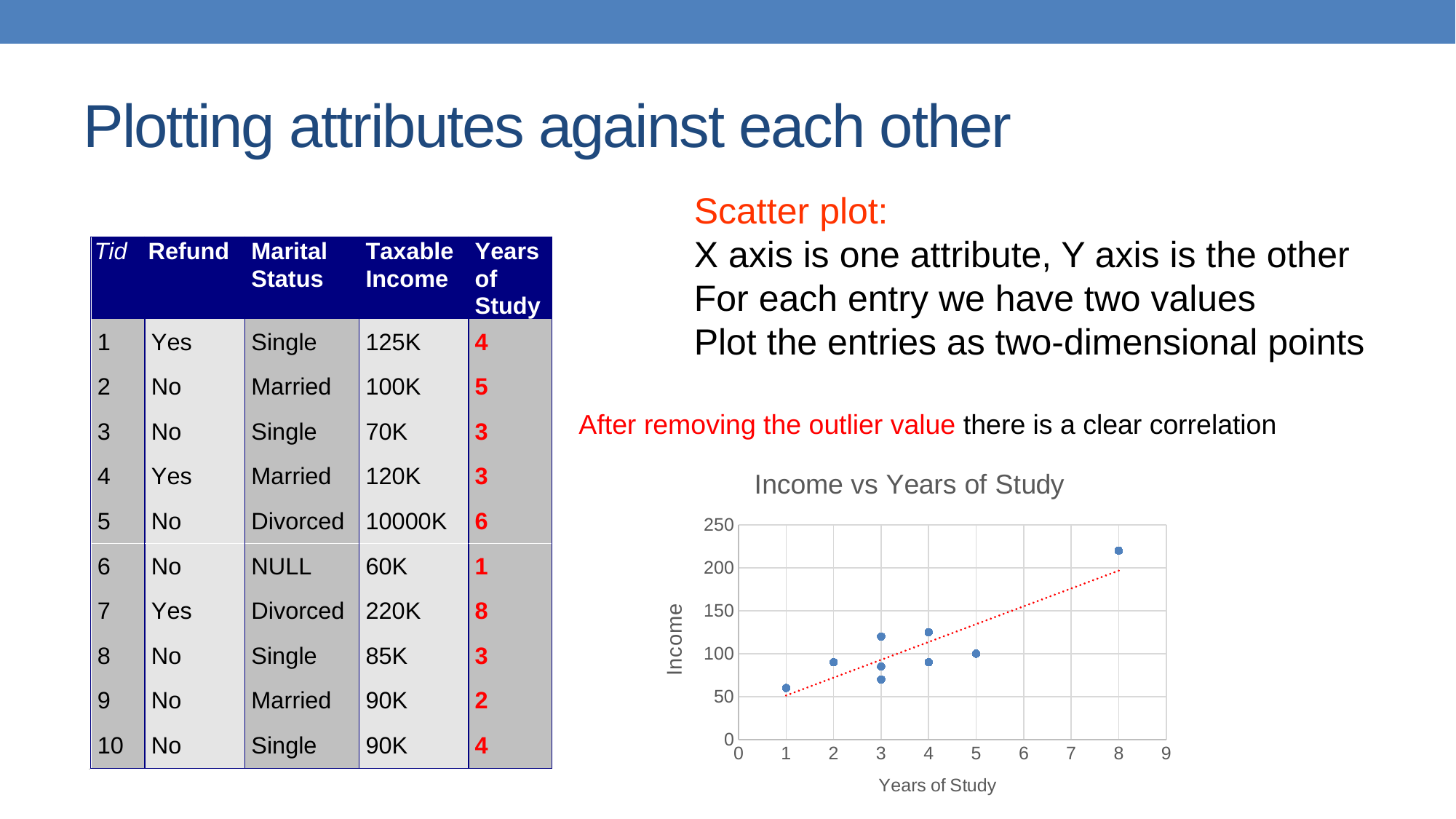
At how many years of study is the point with the highest income? 8 Does income generally rise or fall as years of study increase along the x axis? rise What kind of chart is shown on the slide? scatter plot What is the title of the chart? Income vs Years of Study How many data points are plotted in the chart? 9 Is the income value for the point at 1 year of study greater or less than 100? less Is the income value for the point at 2 years of study greater or less than 50? greater What is the income value of the point at 5 years of study? 100 What is the label of the y axis of the chart? Income At how many years of study is the point with the lowest income? 1 Is the income value for the point at 8 years of study greater or less than 200? greater How many data points are plotted at 3 years of study? 3